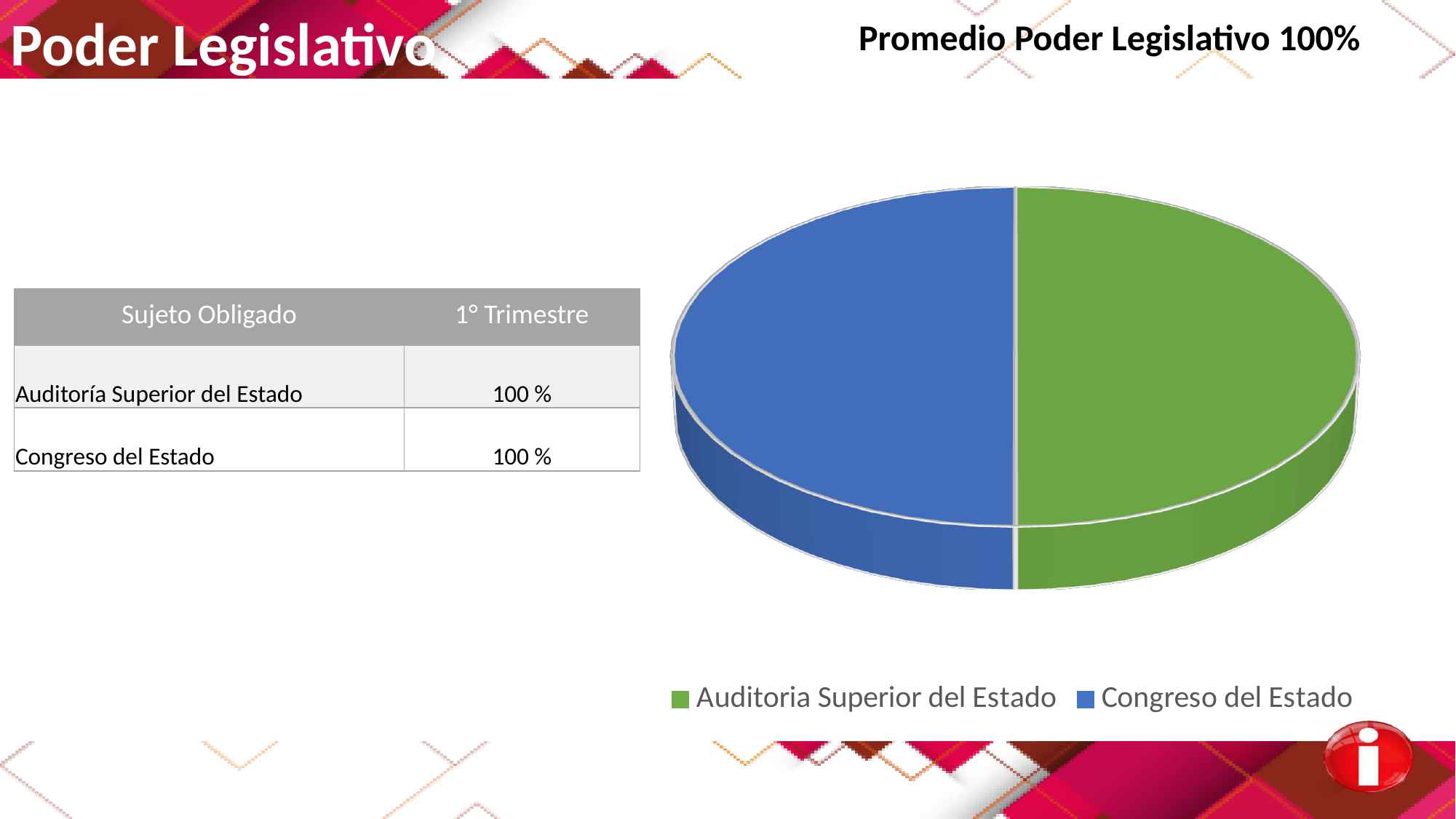
What is the difference between the values for Auditoría Superior del Estado and Congreso del Estado? 0 % What is the 1° Trimestre value for Congreso del Estado? 100 % How many slices does the pie chart have? 2 Which legend entry is shown in green? Auditoria Superior del Estado What kind of chart is shown on the slide? pie chart What is the 1° Trimestre value for Auditoría Superior del Estado? 100 % How many entries does the legend of the pie chart list? 2 Which colour represents Congreso del Estado in the pie chart? blue What share of the pie does the Auditoria Superior del Estado slice represent? 50% What share of the pie does the Congreso del Estado slice represent? 50%